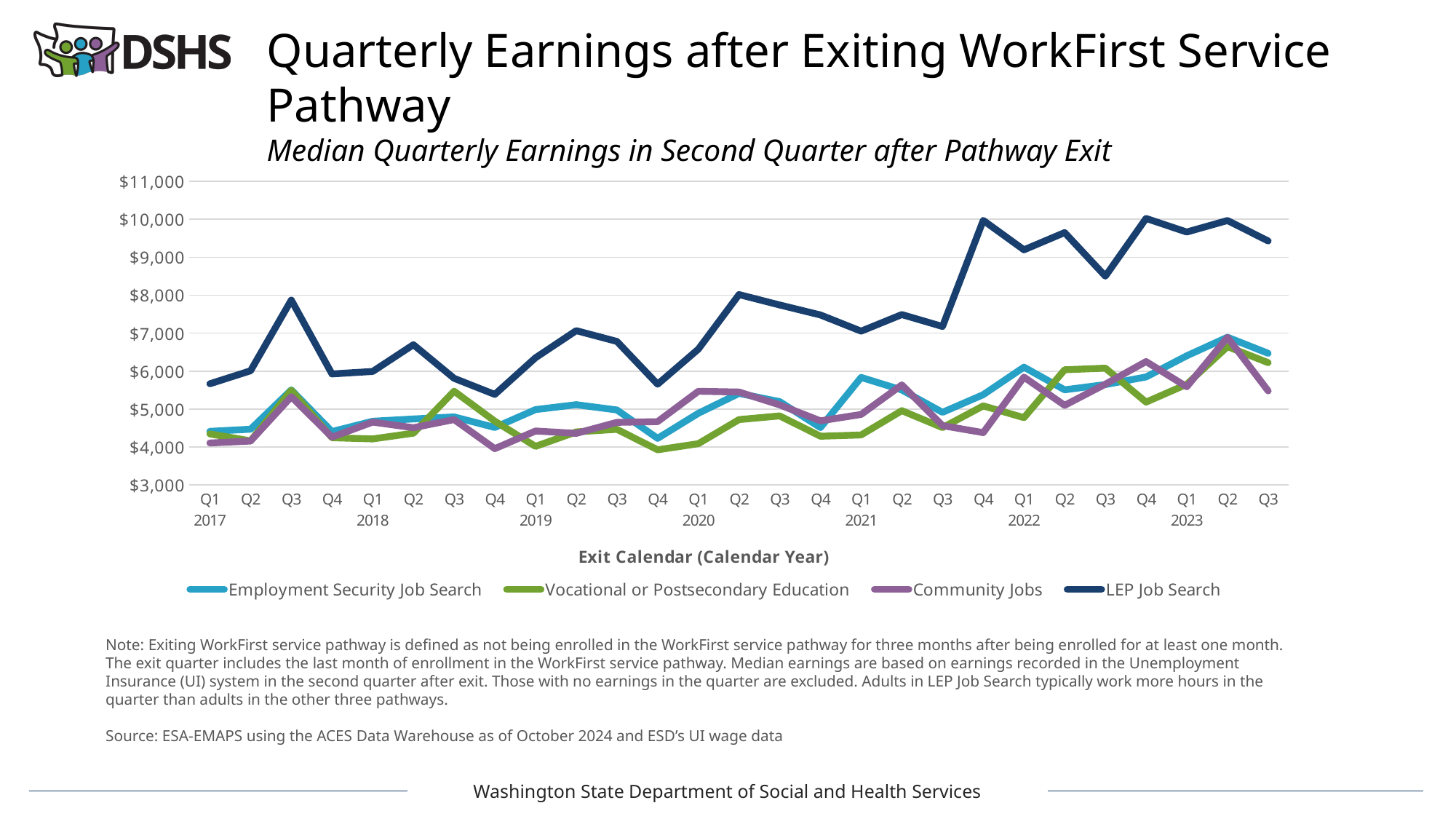
Is the value for LEP Job Search in Q3 2017 greater or less than $7,000? greater Does the LEP Job Search line generally rise or fall from 2017 to 2023? rise How many quarters are plotted along the x axis? 27 Is the value for LEP Job Search in Q4 2021 greater or less than $9,000? greater Is the value for LEP Job Search in Q3 2022 greater or less than $9,000? less Which series has the lowest value in Q1 2017? Community Jobs What is the title of the x axis? Exit Calendar (Calendar Year) In Q3 2023, which is larger: Employment Security Job Search or Community Jobs? Employment Security Job Search How many series does the legend list? 4 Which series has the highest value in Q4 2021? LEP Job Search What kind of chart is shown on the slide? line chart